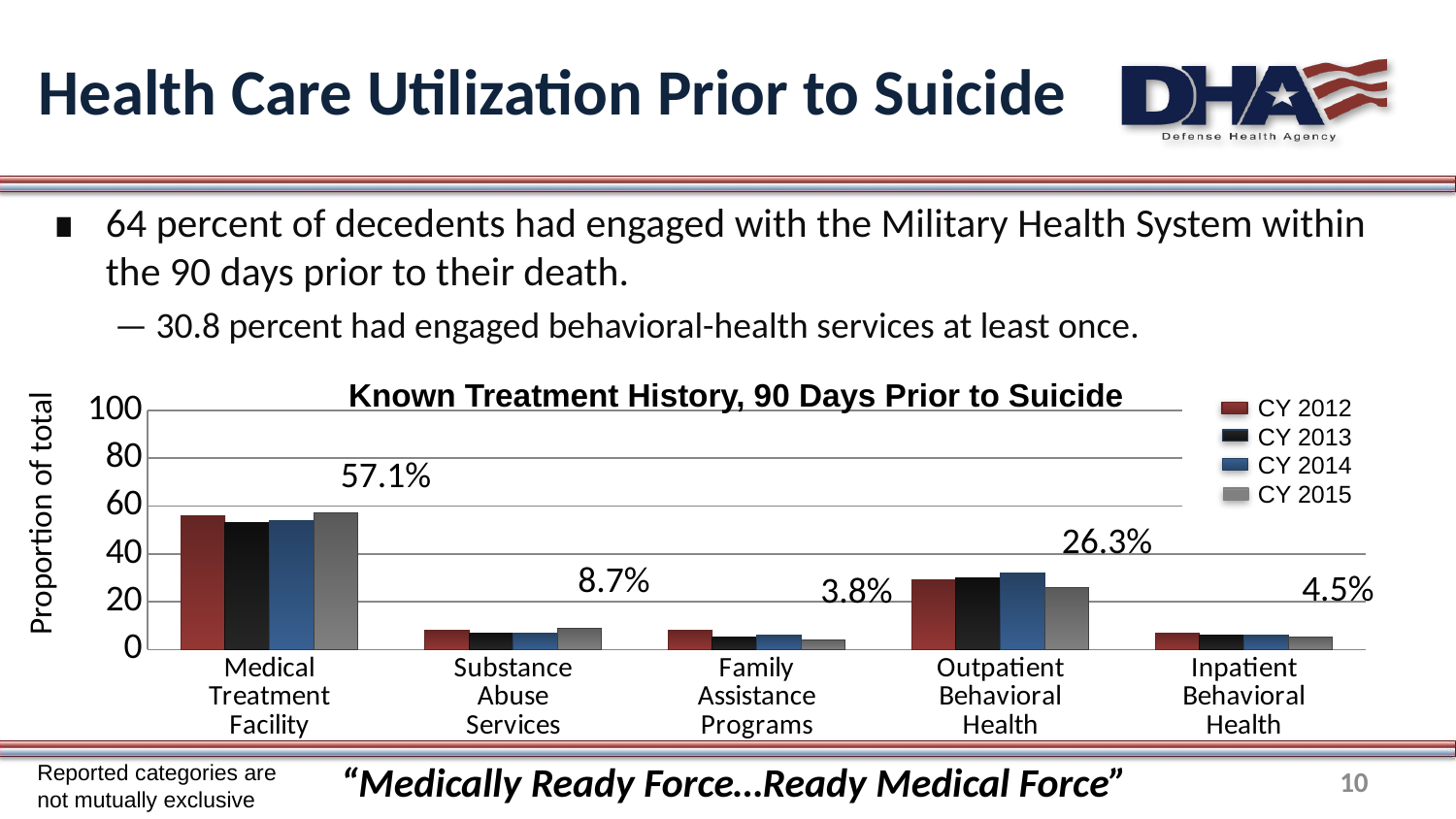
Which category has the highest labeled CY 2015 value? Medical Treatment Facility What is the labeled CY 2015 value for Outpatient Behavioral Health? 26.3% How many series does the legend of the chart list? 4 How many treatment categories are shown on the x axis of the chart? 5 What is the labeled CY 2015 value for Family Assistance Programs? 3.8% What is the difference between the labeled CY 2015 values for Medical Treatment Facility and Outpatient Behavioral Health? 30.8 percentage points Which category has the lowest labeled CY 2015 value? Family Assistance Programs Is the CY 2012 value for Medical Treatment Facility greater or less than 40? greater What kind of chart is shown on the slide? Bar chart What is the labeled CY 2015 value for Substance Abuse Services? 8.7% What is the labeled CY 2015 value for Medical Treatment Facility? 57.1% What is the labeled CY 2015 value for Inpatient Behavioral Health? 4.5%